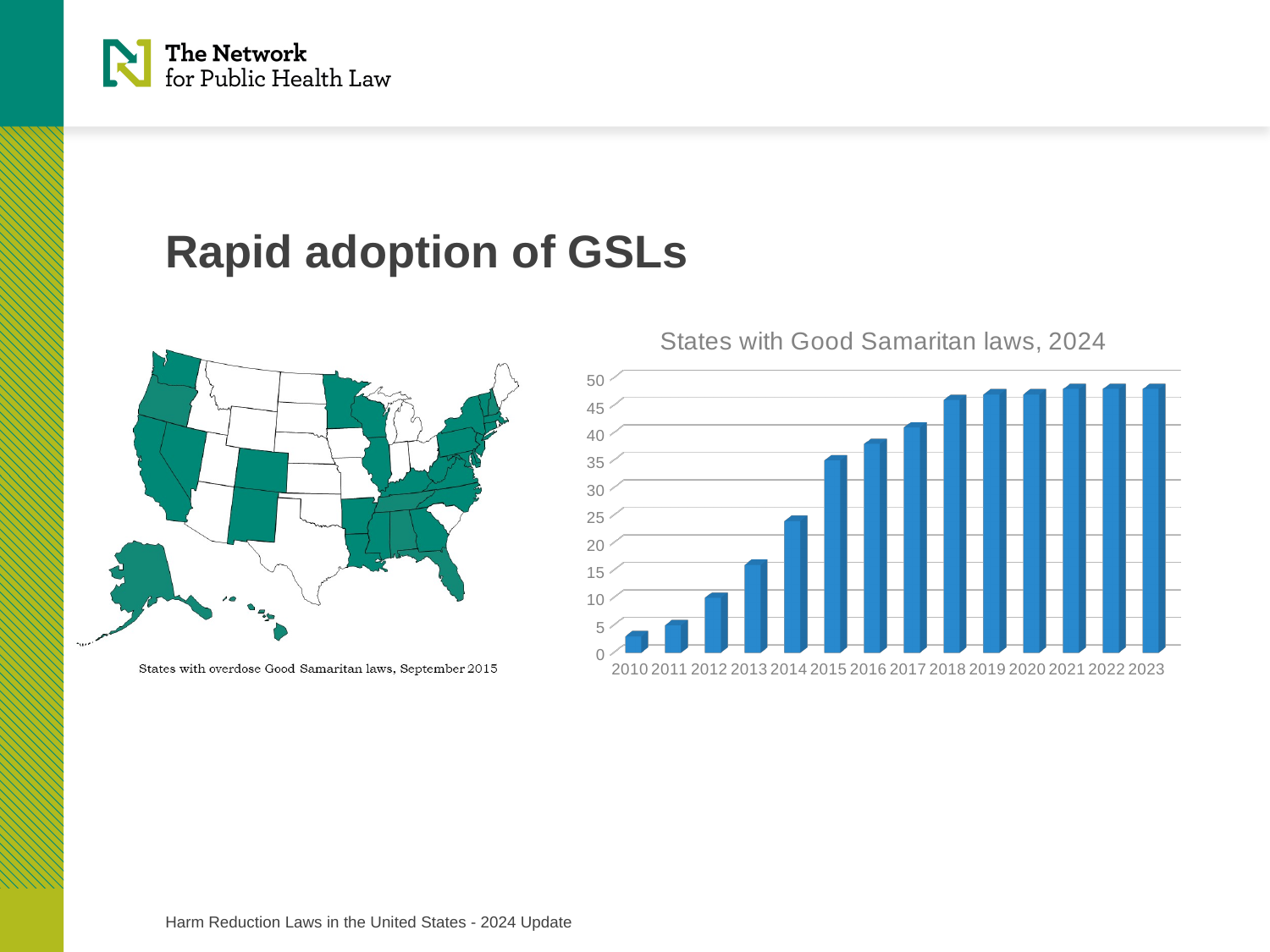
Is the value for 2014 greater or less than 20? greater Which year has the lowest value in the chart? 2010 Is the value for 2010 greater or less than 5? less Which year has the larger value, 2017 or 2018? 2018 What kind of chart is shown on the slide? bar chart How many years are shown on the x axis of the chart? 14 What is the title of the chart? States with Good Samaritan laws, 2024 Is the value for 2023 greater or less than 45? greater Which year has the larger value, 2014 or 2015? 2015 Do the values in the chart rise or fall from 2010 to 2023? rise